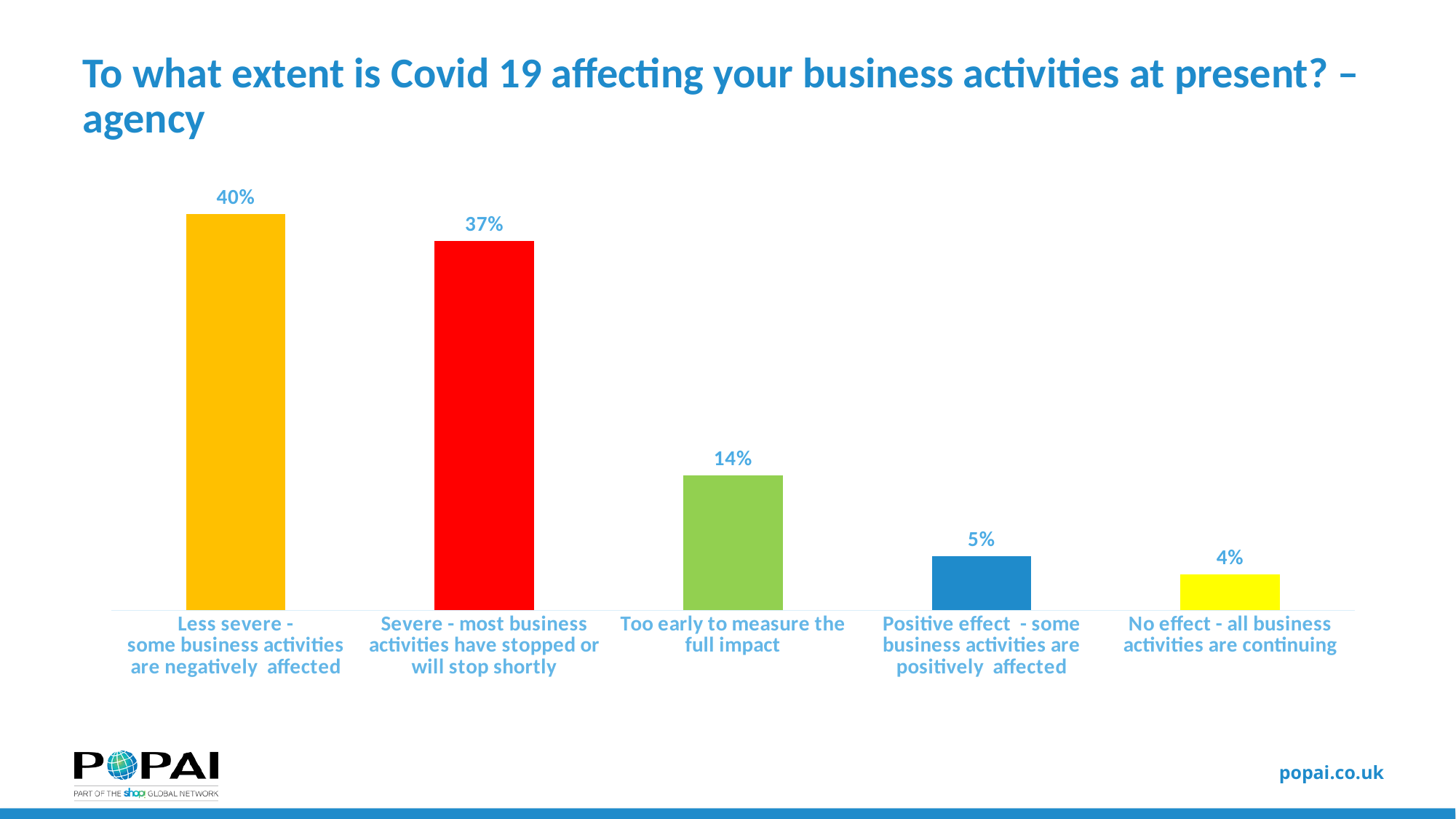
What is the difference between 'Too early to measure the full impact' and 'Positive effect - some business activities are positively affected'? 9% Which category has the lowest value? No effect - all business activities are continuing What type of chart is shown on the slide? Bar chart What value is shown for 'Severe - most business activities have stopped or will stop shortly'? 37% Which is larger: the value for 'Positive effect' or the value for 'No effect'? Positive effect What value is shown for 'No effect - all business activities are continuing'? 4% What colour is the bar for 'Severe - most business activities have stopped or will stop shortly'? Red What is the difference between the 'Less severe' and 'Severe' values? 3% What percentage said it is 'Too early to measure the full impact'? 14% Which category has the highest value? Less severe - some business activities are negatively affected What percentage of agency respondents said the effect is 'Less severe - some business activities are negatively affected'? 40% How many categories are shown in the chart? 5